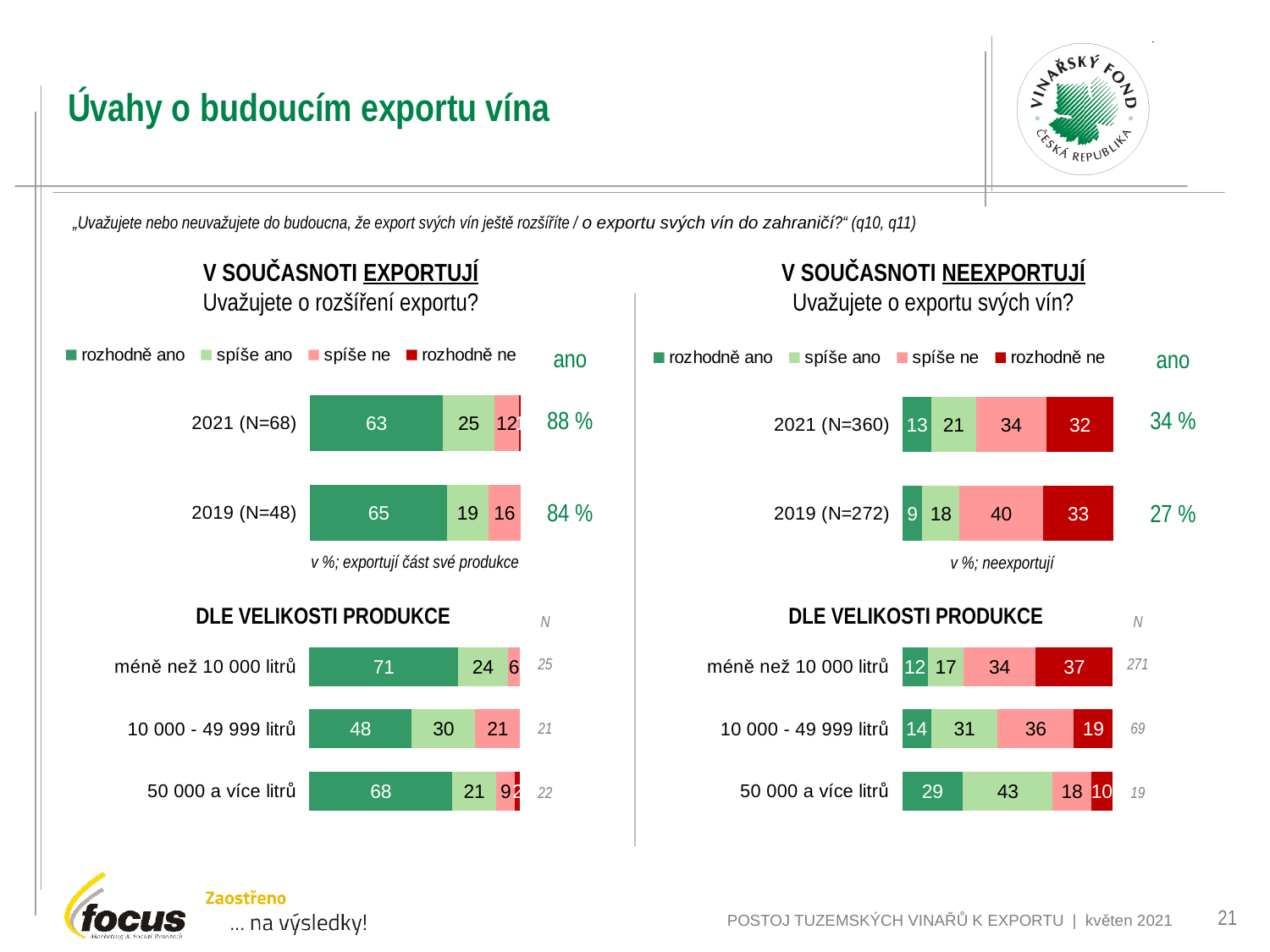
In the right 'Dle velikosti produkce' chart (non-exporters), what is the N shown for 'méně než 10 000 litrů'? 271 In the 'V současnosti exportují' chart by year, what is the 'rozhodně ano' value for 2021 (N=68)? 63 In the 'V současnosti neexportují' chart by year, what is the difference between the 'spíše ne' values for 2019 and 2021? 6 In the 'V současnosti neexportují' chart by year, what is the 'ano' percentage for 2019 (N=272)? 27 % In the left 'Dle velikosti produkce' chart (exporters), what is the 'spíše ano' value for '10 000 - 49 999 litrů'? 30 In the 'V současnosti neexportují' chart by year, what is the 'rozhodně ne' value for 2021 (N=360)? 32 In the right 'Dle velikosti produkce' chart (non-exporters), which production size category has the lowest 'rozhodně ne' value? 50 000 a více litrů What type of chart is used in the 'V současnosti neexportují' chart by year? Stacked bar chart In the 'V současnosti exportují' chart by year, what is the 'ano' percentage shown for 2019 (N=48)? 84 % In the right 'Dle velikosti produkce' chart (non-exporters), what is the 'spíše ano' value for '50 000 a více litrů'? 43 How many series does the legend list in the 'V současnosti exportují' chart? 4 In the left 'Dle velikosti produkce' chart (exporters), which production size category has the highest 'rozhodně ano' value? méně než 10 000 litrů